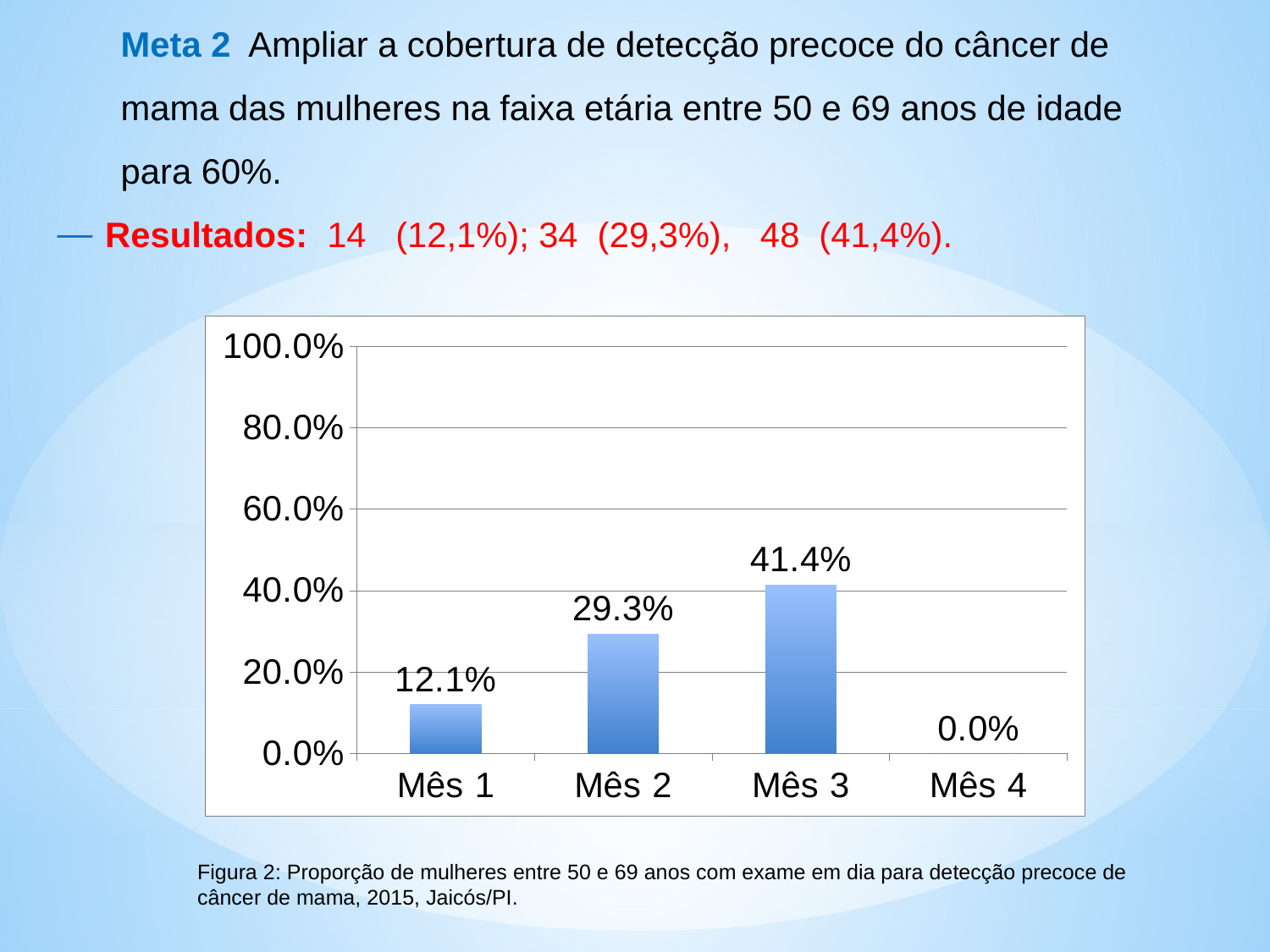
Is the value for Mês 3 greater or less than 60.0%? less What is the value for Mês 3? 41.4% What is the value for Mês 1? 12.1% Which is larger, the value for Mês 1 or the value for Mês 2? Mês 2 What is the value for Mês 2? 29.3% How many months are shown on the x axis? 4 What is the difference between the values for Mês 3 and Mês 2? 12.1% Which month has the lowest value? Mês 4 What is the difference between the values for Mês 2 and Mês 1? 17.2% Which month has the highest value? Mês 3 What kind of chart is shown on the slide? bar chart What is the value for Mês 4? 0.0%